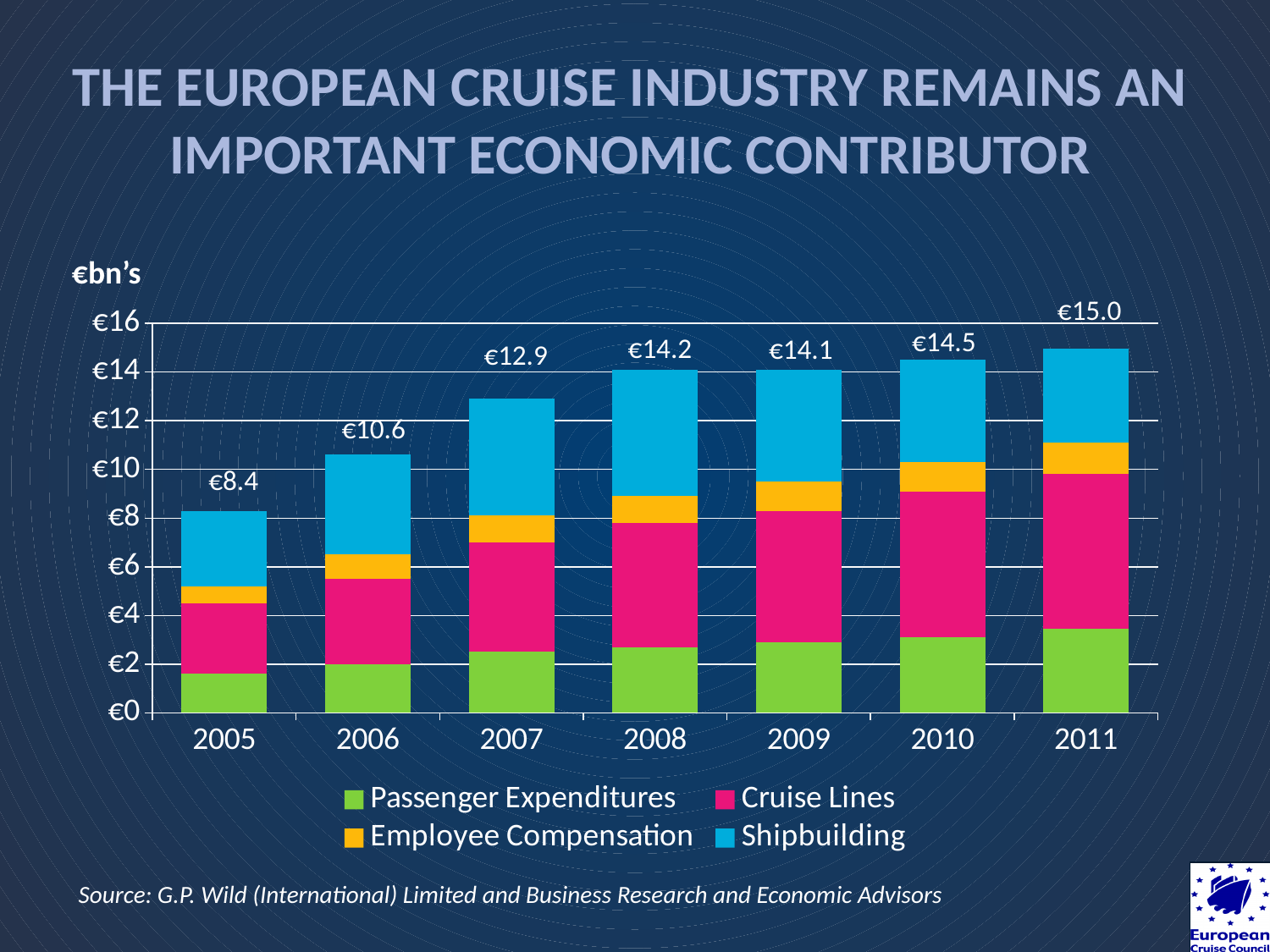
What kind of chart is shown on the slide? Stacked bar chart Which year has the lowest total value? 2005 What is the total value labelled on the bar for 2011? €15.0 Which year has the highest total value? 2011 What is the difference between the total for 2011 and the total for 2005? €6.6 What is the total value labelled on the bar for 2005? €8.4 Do the total values rise or fall from 2005 to 2008? Rise How many series does the legend list? 4 What is the total value labelled on the bar for 2008? €14.2 How many years are shown on the x axis? 7 Is the Passenger Expenditures value for 2011 greater or less than €2? greater Which year has the larger total, 2008 or 2009? 2008